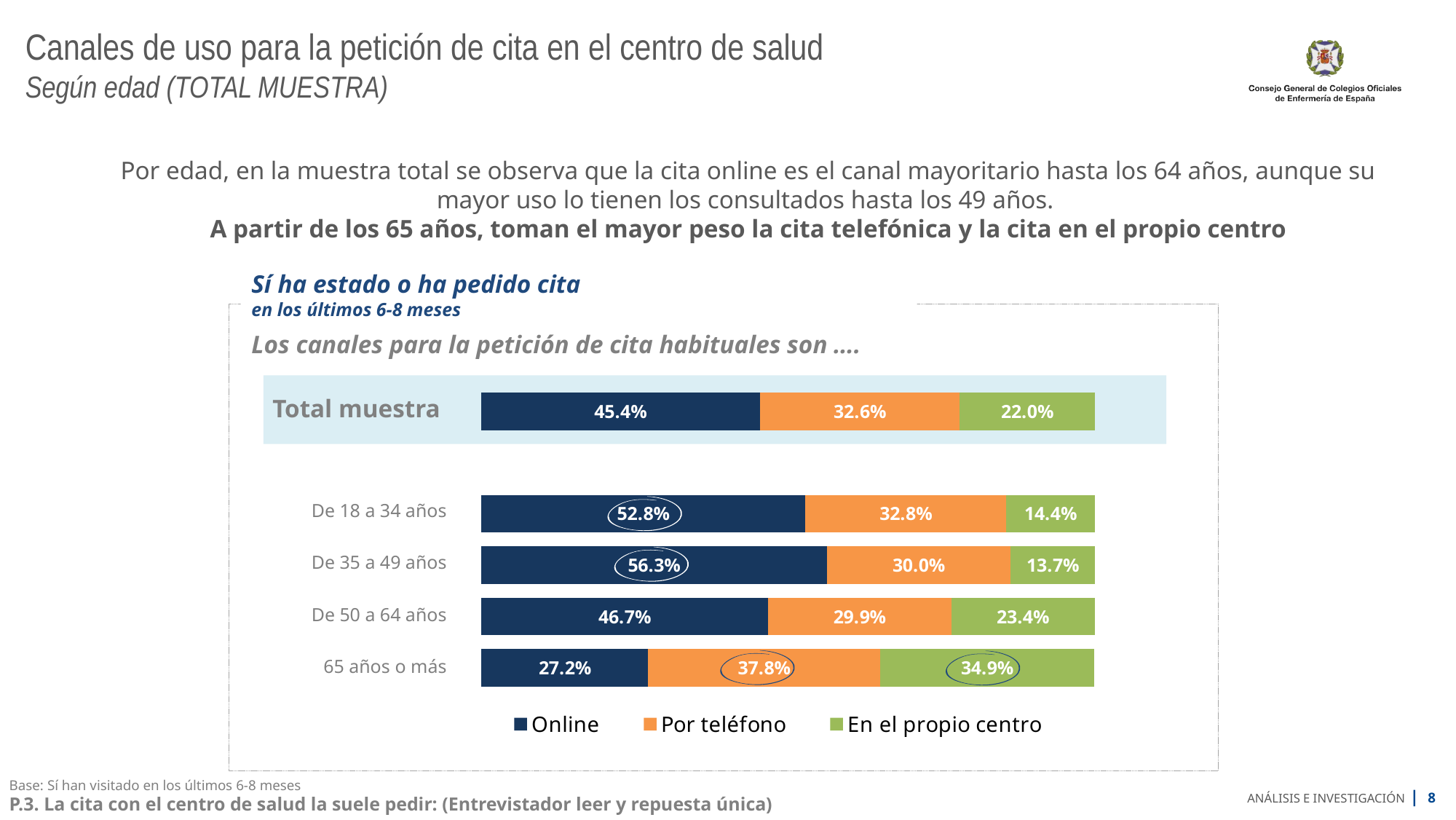
Which age group has the lowest 'En el propio centro' value? De 35 a 49 años Which age group has the highest Online value? De 35 a 49 años What is the 'Por teléfono' value for the '65 años o más' group? 37.8% What is the Online value for the 'De 35 a 49 años' group? 56.3% What is the total of the three segments in the 'De 50 a 64 años' bar? 100.0% How many series does the legend list? 3 How many age groups are shown below the 'Total muestra' bar? 4 Which colour represents the 'Por teléfono' series in the legend? Orange What kind of chart is shown on the slide? Stacked bar chart What is the 'En el propio centro' value for 'Total muestra'? 22.0% What is the difference between the Online values for 'De 18 a 34 años' and '65 años o más'? 25.6% Which is larger for the '65 años o más' group: 'Por teléfono' or 'En el propio centro'? Por teléfono